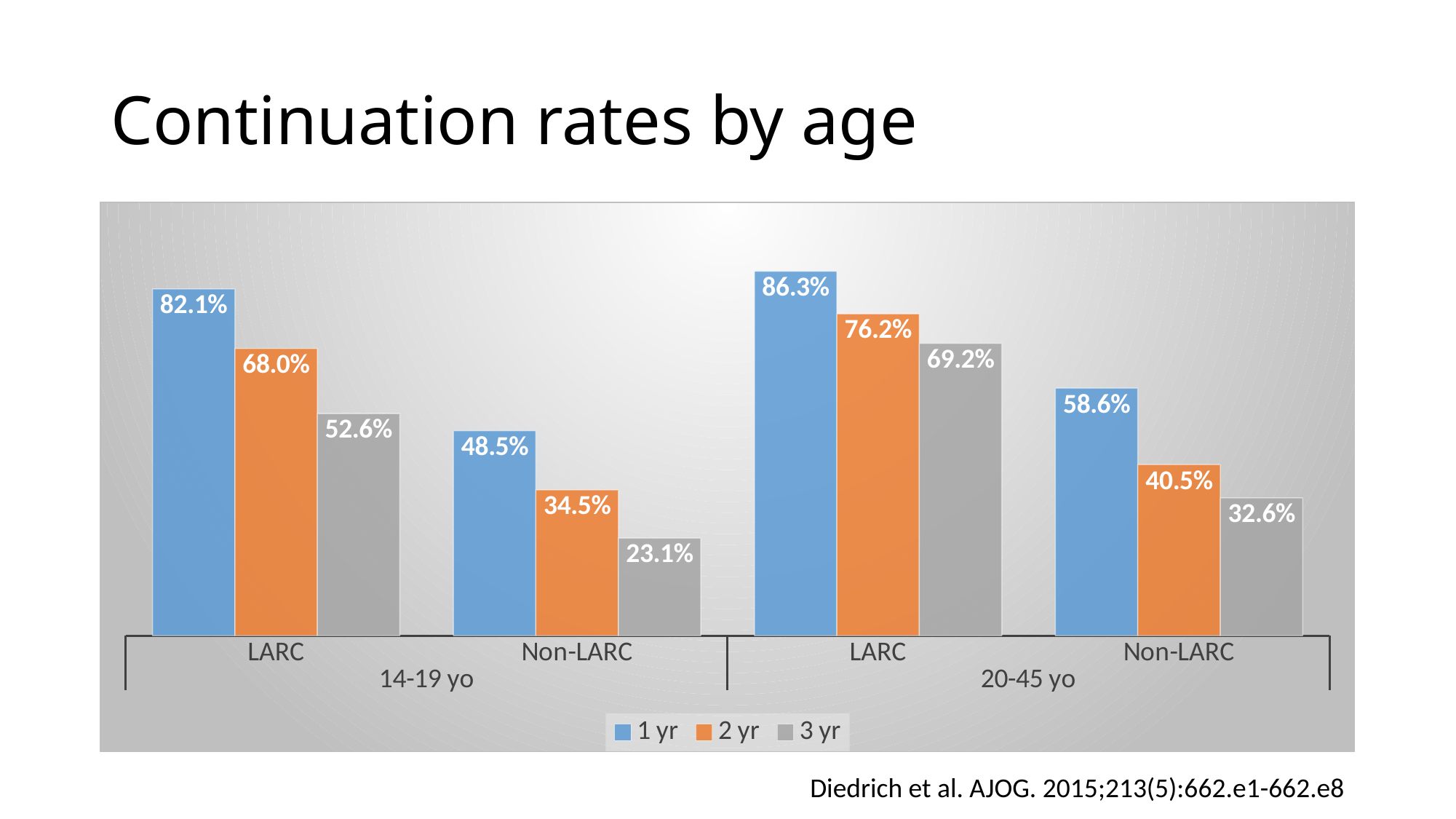
What is the 3 yr continuation rate for Non-LARC in the 20-45 yo group? 32.6% What is the difference between the 1 yr LARC rate and the 1 yr Non-LARC rate in the 20-45 yo group? 27.7% How many series does the legend list? 3 What colour represents the 2 yr series in the legend? Orange Which bar has the lowest value on the chart? Non-LARC, 14-19 yo, 3 yr (23.1%) What is the 1 yr continuation rate for LARC in the 14-19 yo group? 82.1% What is the 2 yr continuation rate for Non-LARC in the 14-19 yo group? 34.5% Which bar has the highest value on the chart? LARC, 20-45 yo, 1 yr (86.3%) What type of chart is shown on the slide? Bar chart Within each group, do the continuation rates rise or fall from 1 yr to 3 yr? Fall How many category groups (LARC/Non-LARC by age) are shown on the x axis? 4 Which is larger: the 3 yr LARC rate for 14-19 yo or the 1 yr Non-LARC rate for 14-19 yo? 3 yr LARC rate for 14-19 yo (52.6%)